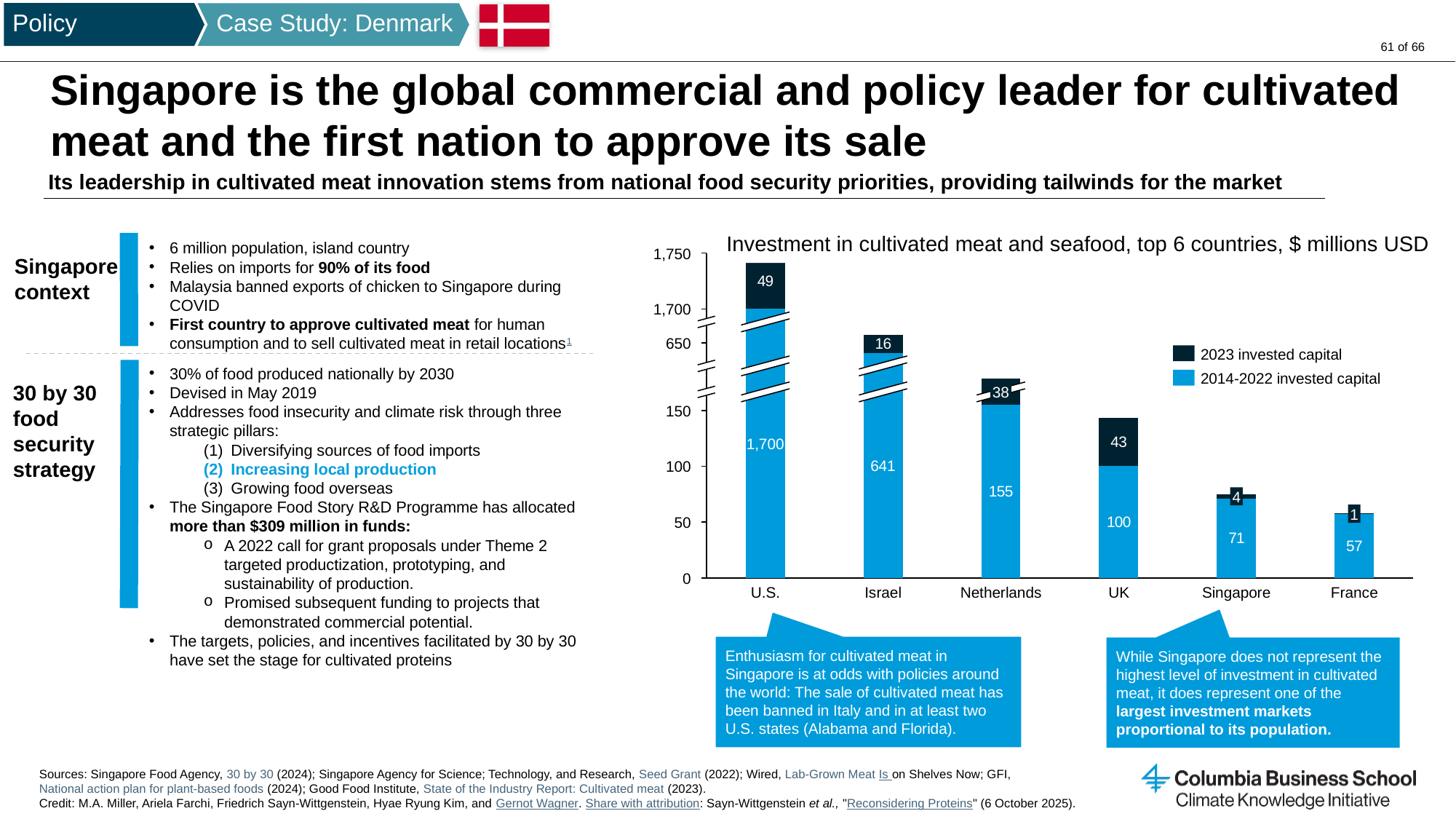
What is the total invested capital (2014-2022 plus 2023) for the UK? 143 Which is larger, the 2023 invested capital for the Netherlands or for Israel? Netherlands What is the 2014-2022 invested capital for Israel? 641 What is the title of the chart? Investment in cultivated meat and seafood, top 6 countries, $ millions USD What is the 2014-2022 invested capital for Singapore? 71 Which country has the highest 2014-2022 invested capital? U.S. What is the difference between the 2014-2022 invested capital for the Netherlands and the UK? 55 How many countries are shown on the x axis? 6 Which country has the lowest 2023 invested capital? France What is the 2023 invested capital for the UK? 43 How many series does the legend list? 2 What type of chart is shown on the slide? Stacked bar chart